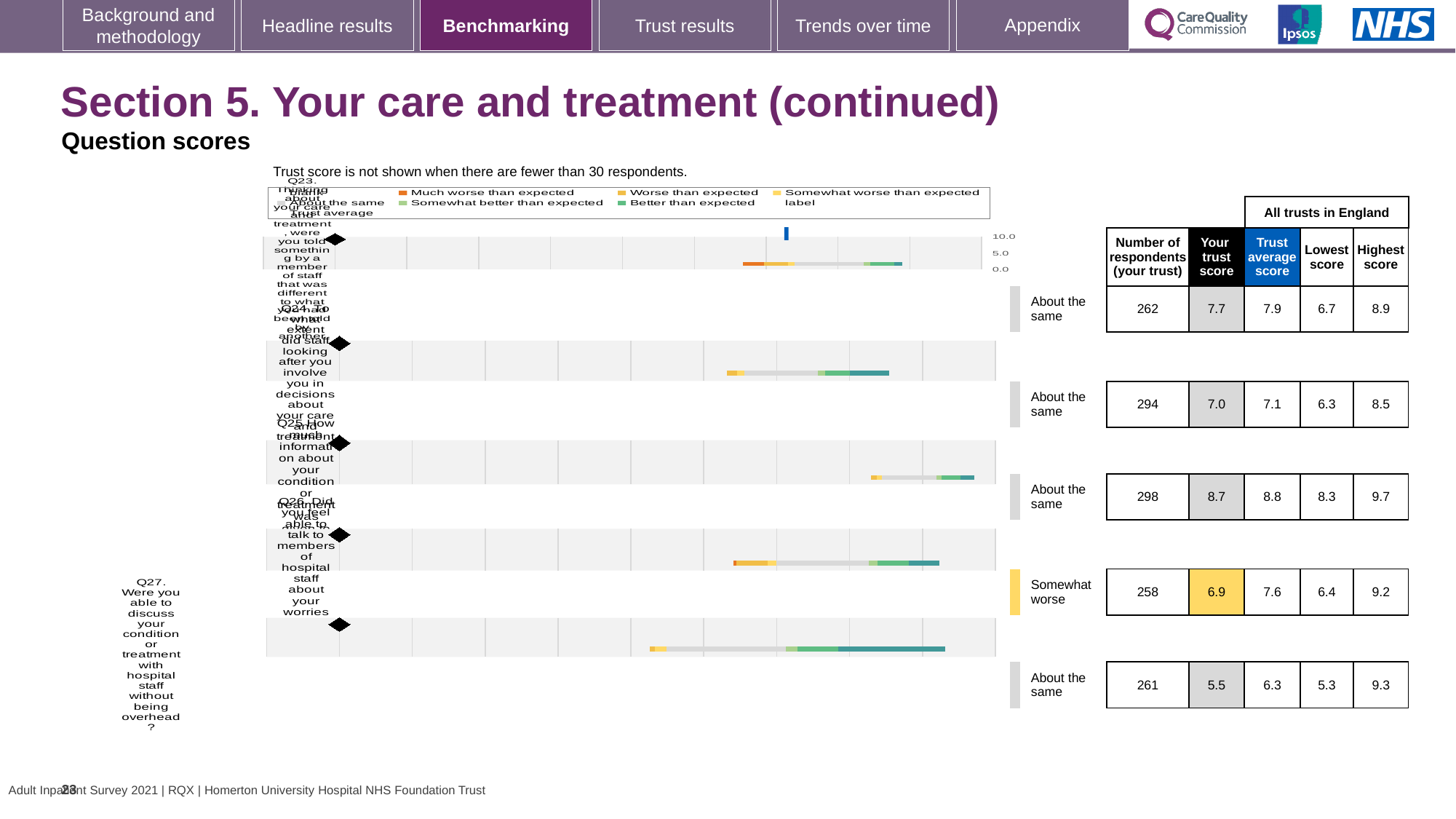
What is the highest score across all trusts in England for Q27? 9.3 Which question has the largest number of respondents? Q25 How many questions are shown on the slide? 5 Which question has the lowest 'Your trust score'? Q27 What kind of chart is used to show the question scores? Bar chart What is the lowest score across all trusts in England for Q24? 6.3 Which question is rated 'Somewhat worse' rather than 'About the same'? Q26 Which question has the highest 'Your trust score'? Q25 For Q26, what is the difference between the trust average score and your trust score? 0.7 What is the 'Your trust score' for Q26 (Did you feel able to talk to members of hospital staff about your worries)? 6.9 For Q23, which is larger: your trust score or the trust average score? Trust average score How many respondents (your trust) are shown for Q25? 298